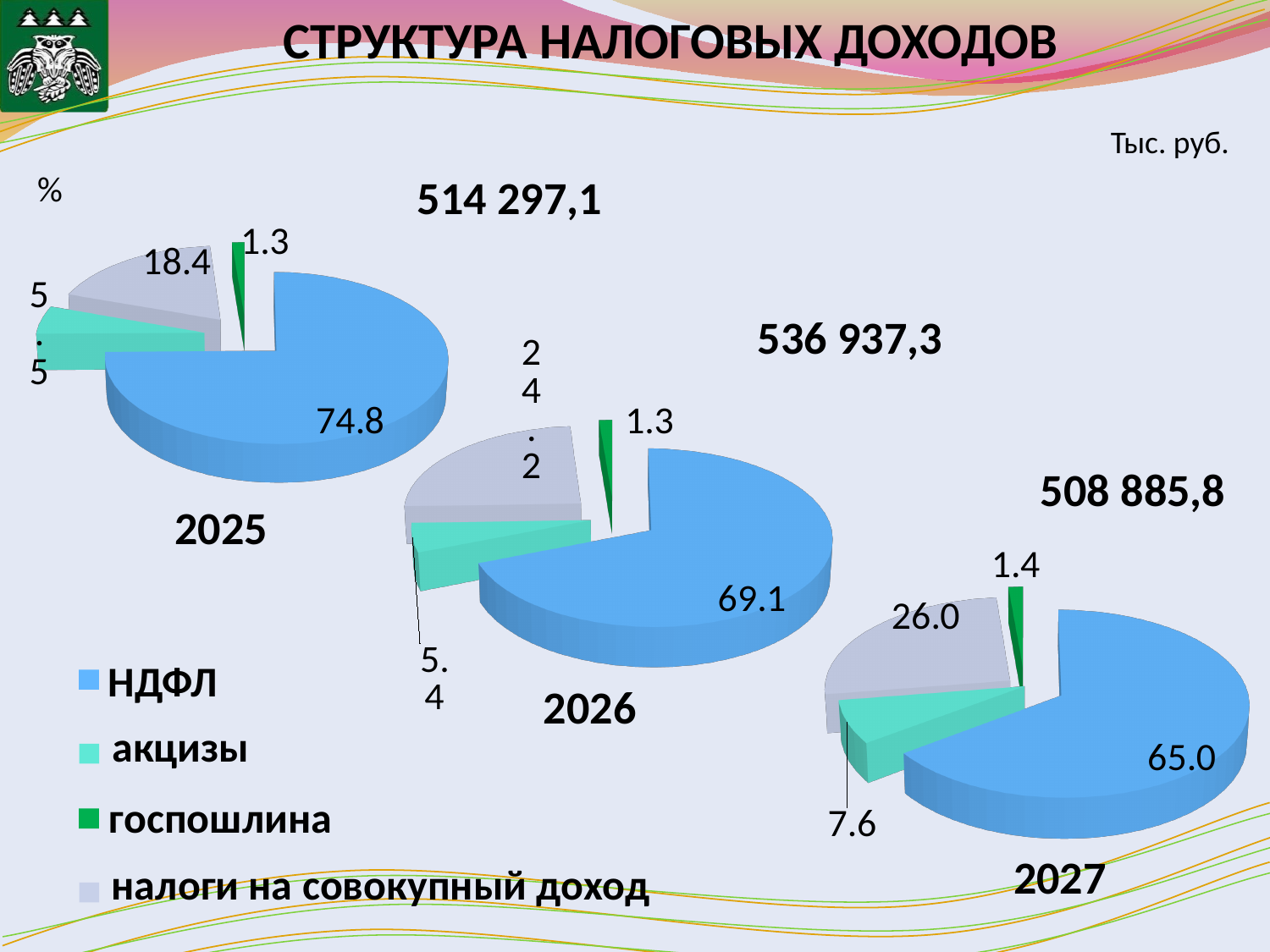
How many entries does the legend list? 4 What total value (тыс. руб.) is shown above the 2026 pie chart? 536 937,3 How does the share of НДФЛ change from the 2025 chart to the 2027 chart? It falls In the 2027 pie chart, what share does налоги на совокупный доход have? 26.0 In the 2026 pie chart, which category has the largest share? НДФЛ In the 2025 pie chart, what share does НДФЛ have? 74.8 In the 2027 pie chart, which is larger: the share of акцизы or the share of налоги на совокупный доход? налоги на совокупный доход What kind of charts are shown on the slide? Pie charts What is the difference between the НДФЛ share in the 2025 pie chart and the НДФЛ share in the 2027 pie chart? 9.8 In the 2026 pie chart, what share does акцизы have? 5.4 In the 2027 pie chart, what share does госпошлина have? 1.4 In the 2025 pie chart, which category has the smallest share? госпошлина